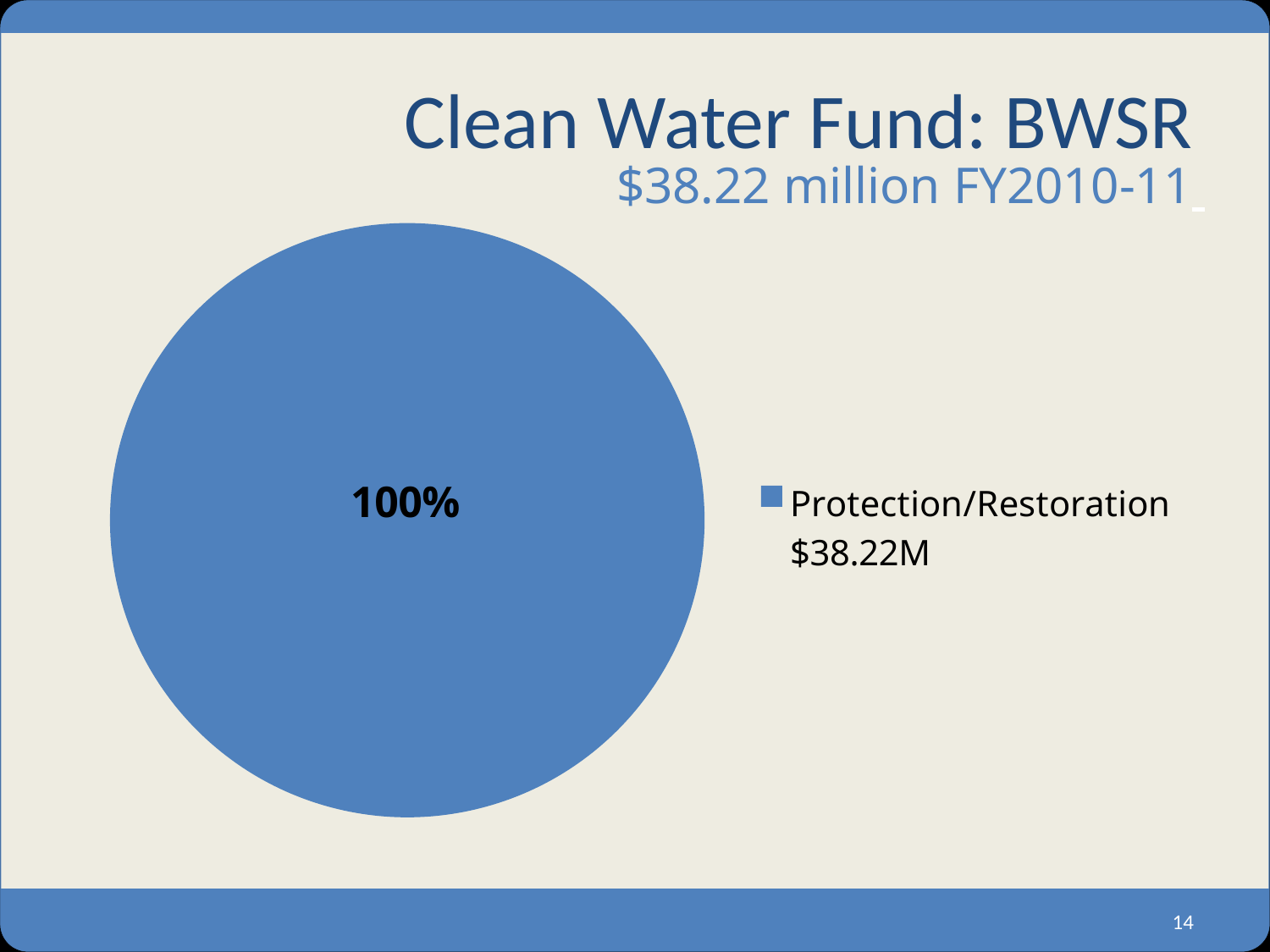
What share of the pie does Protection/Restoration $38.22M represent? 100% How many entries does the legend list? 1 What percentage label is printed on the pie slice? 100% How many slices does the pie chart have? 1 What dollar amount is shown in the legend for Protection/Restoration? $38.22M What is the title of the slide containing the pie chart? Clean Water Fund: BWSR What kind of chart is shown on the slide? pie chart What is the legend entry for the pie chart? Protection/Restoration $38.22M